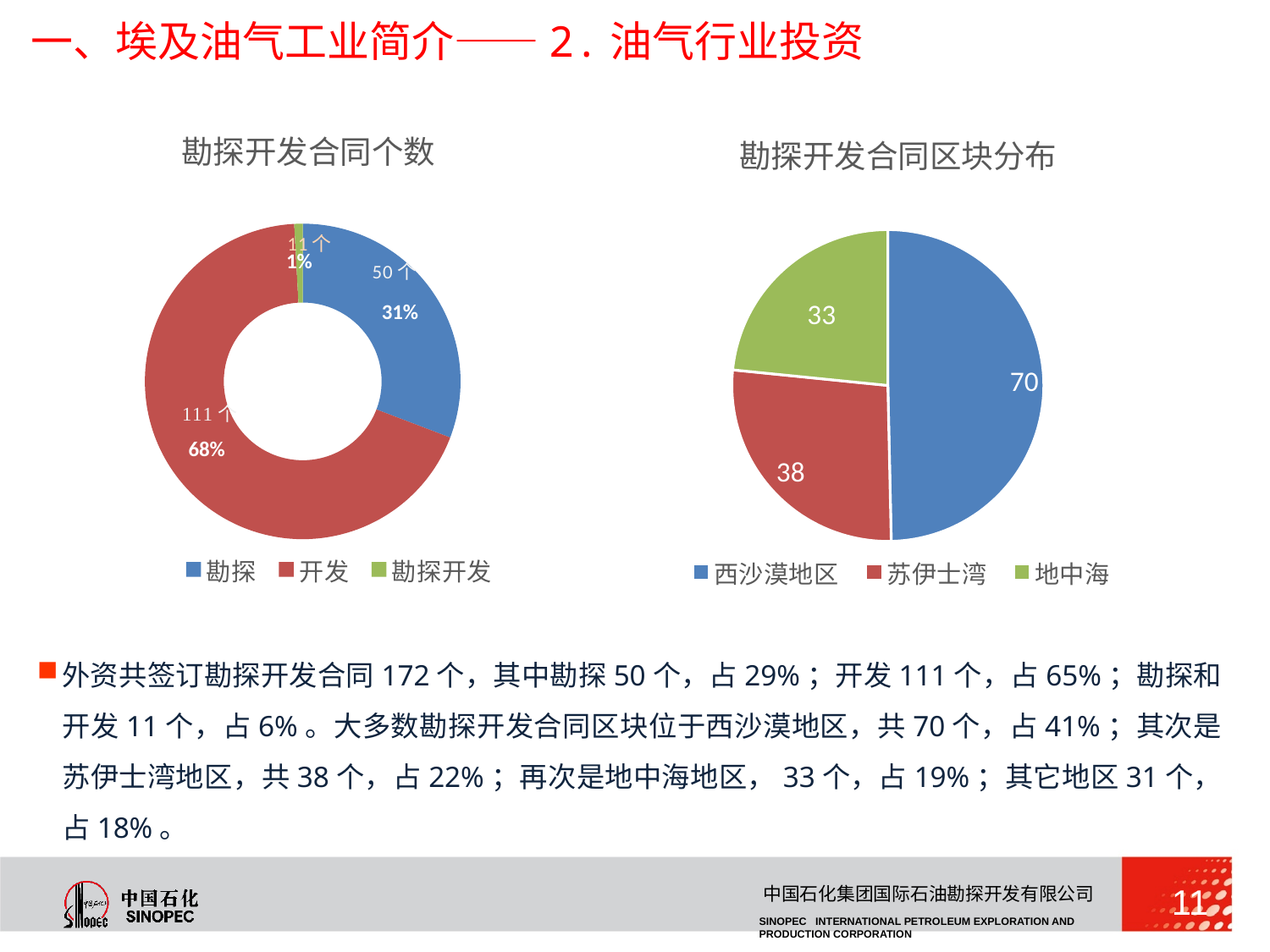
In the chart titled 勘探开发合同区块分布, which region has the smallest value? 地中海 In the chart titled 勘探开发合同区块分布, what is the difference between the values for 西沙漠地区 and 苏伊士湾? 32 In the chart titled 勘探开发合同个数, which category has the largest number of contracts? 开发 In the chart titled 勘探开发合同个数, how many contracts are shown for 勘探? 50 个 In the chart titled 勘探开发合同个数, what percentage label is shown for 开发? 68% In the chart titled 勘探开发合同个数, what percentage label is shown for 勘探? 31% In the chart titled 勘探开发合同个数, how many contracts are shown for 开发? 111 个 In the chart titled 勘探开发合同区块分布, what is the value for 西沙漠地区? 70 In the chart titled 勘探开发合同个数, how many categories does the legend list? 3 In the chart titled 勘探开发合同区块分布, which is larger, the value for 苏伊士湾 or the value for 地中海? 苏伊士湾 In the chart titled 勘探开发合同个数, what is the difference between the number of 开发 contracts and 勘探 contracts? 61 个 What kind of chart is the chart titled 勘探开发合同区块分布? Pie chart